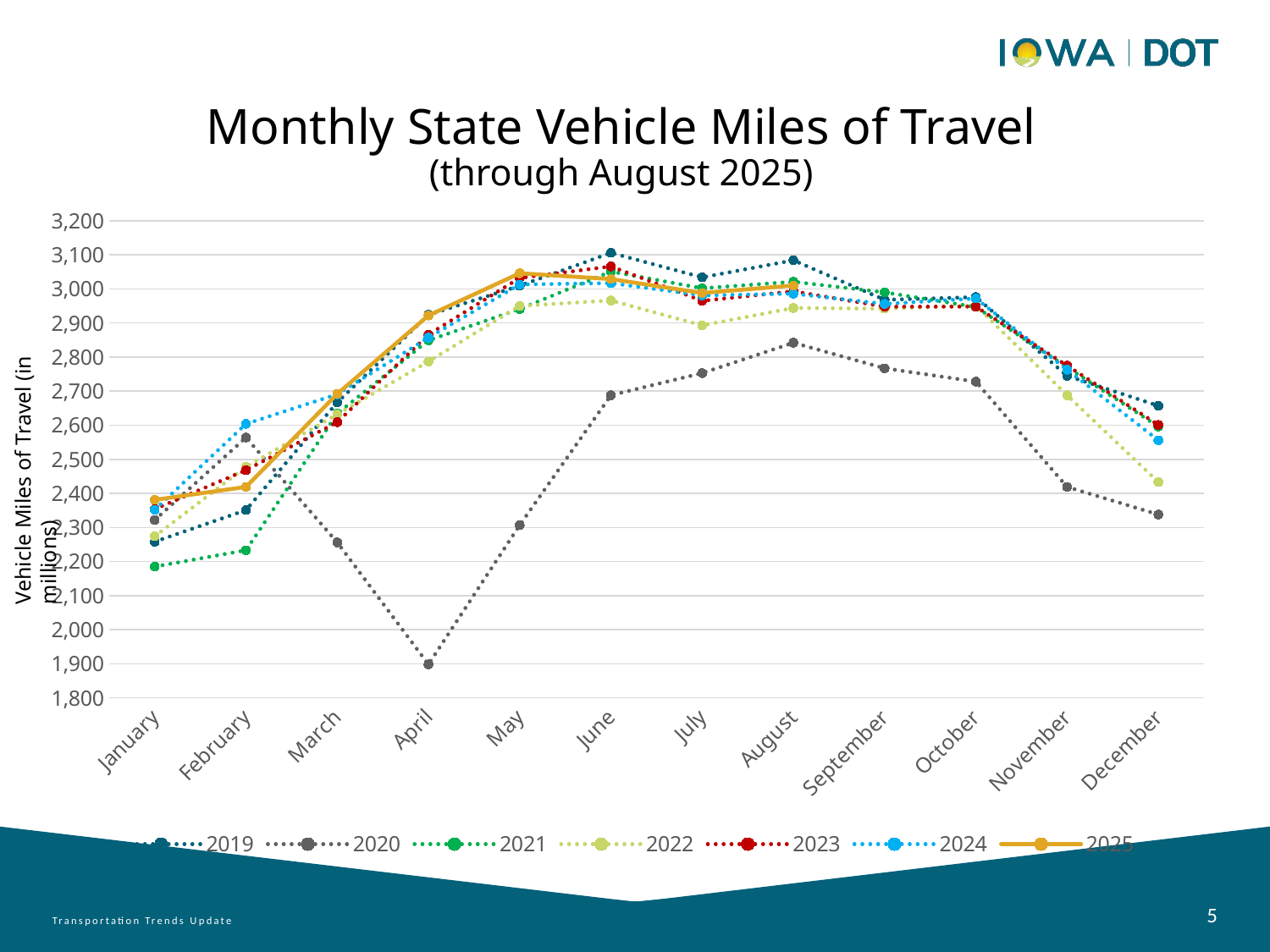
How many series does the legend list? 7 How many months are shown along the x axis? 12 Is the value for 2020 in April greater or less than 2,000? less Does the 2025 series rise or fall from January to May? rise Which year's series has the lowest value in April? 2020 Which is larger in April, the value for 2019 or the value for 2020? 2019 Is the value for 2025 in May greater or less than 3,000? greater In which month does the 2020 series reach its lowest value? April Does the 2020 series rise or fall from February to April? fall Is the value for 2022 in December greater or less than 2,500? less What kind of chart is shown on the slide? line chart Which year's series is drawn as a solid line rather than a dotted line? 2025